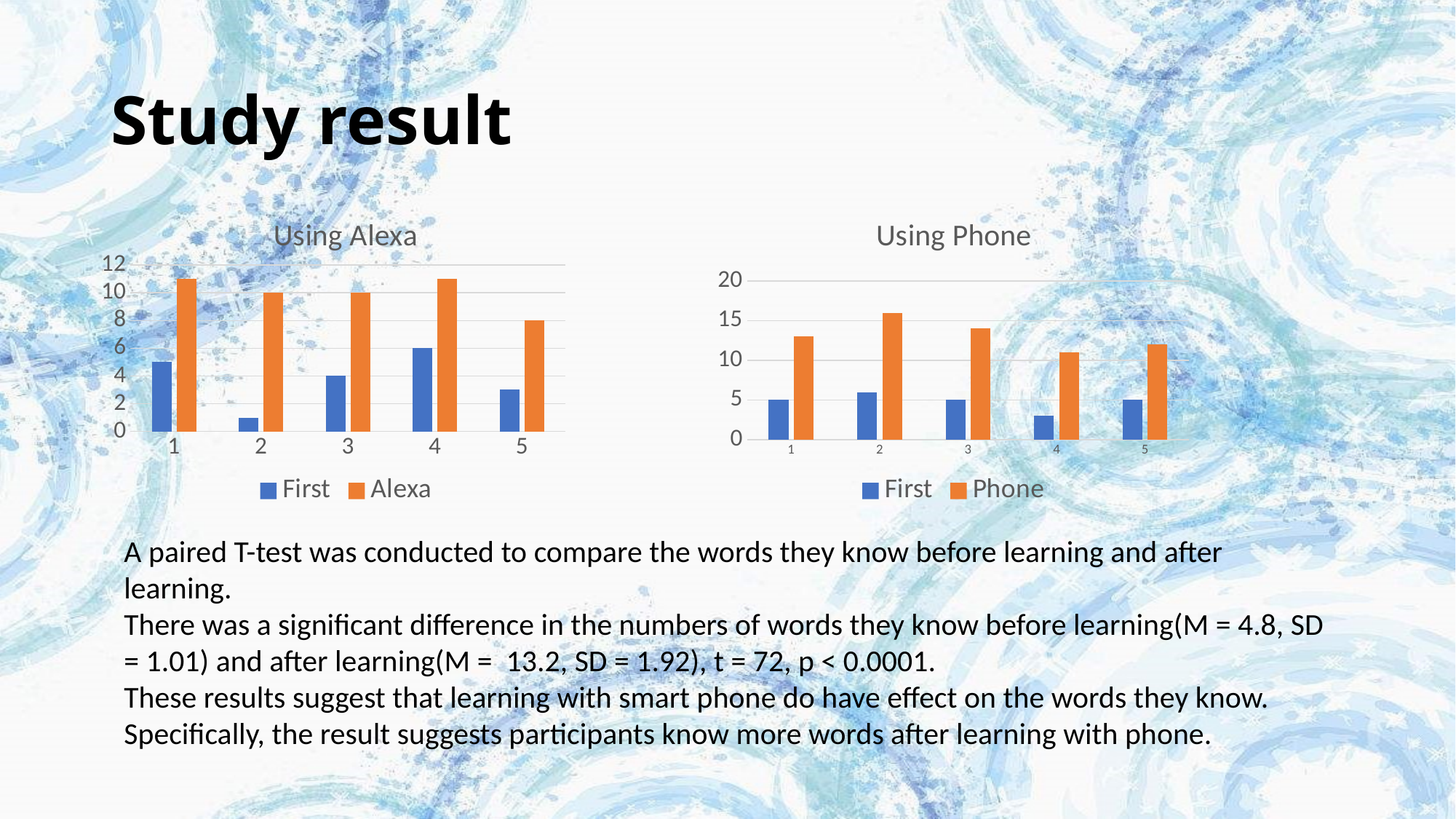
In the "Using Alexa" chart, which category has the lowest Alexa value? 5 How many series does the legend of the "Using Phone" chart list? 2 In the "Using Alexa" chart, what is the First value for category 4? 6 In the "Using Phone" chart, is the Phone value for category 2 greater or less than 15? greater In the "Using Phone" chart, which category has the highest Phone value? 2 In the "Using Phone" chart, what is the First value for category 1? 5 In the "Using Alexa" chart, is the First value for category 2 greater or less than 2? less In the "Using Phone" chart, for category 4, which is larger: the First value or the Phone value? Phone How many categories are shown on the x axis of the "Using Alexa" chart? 5 In the "Using Alexa" chart, what is the Alexa value for category 5? 8 What are the two legend entries of the "Using Alexa" chart? First and Alexa What kind of chart is the "Using Alexa" chart? Bar chart